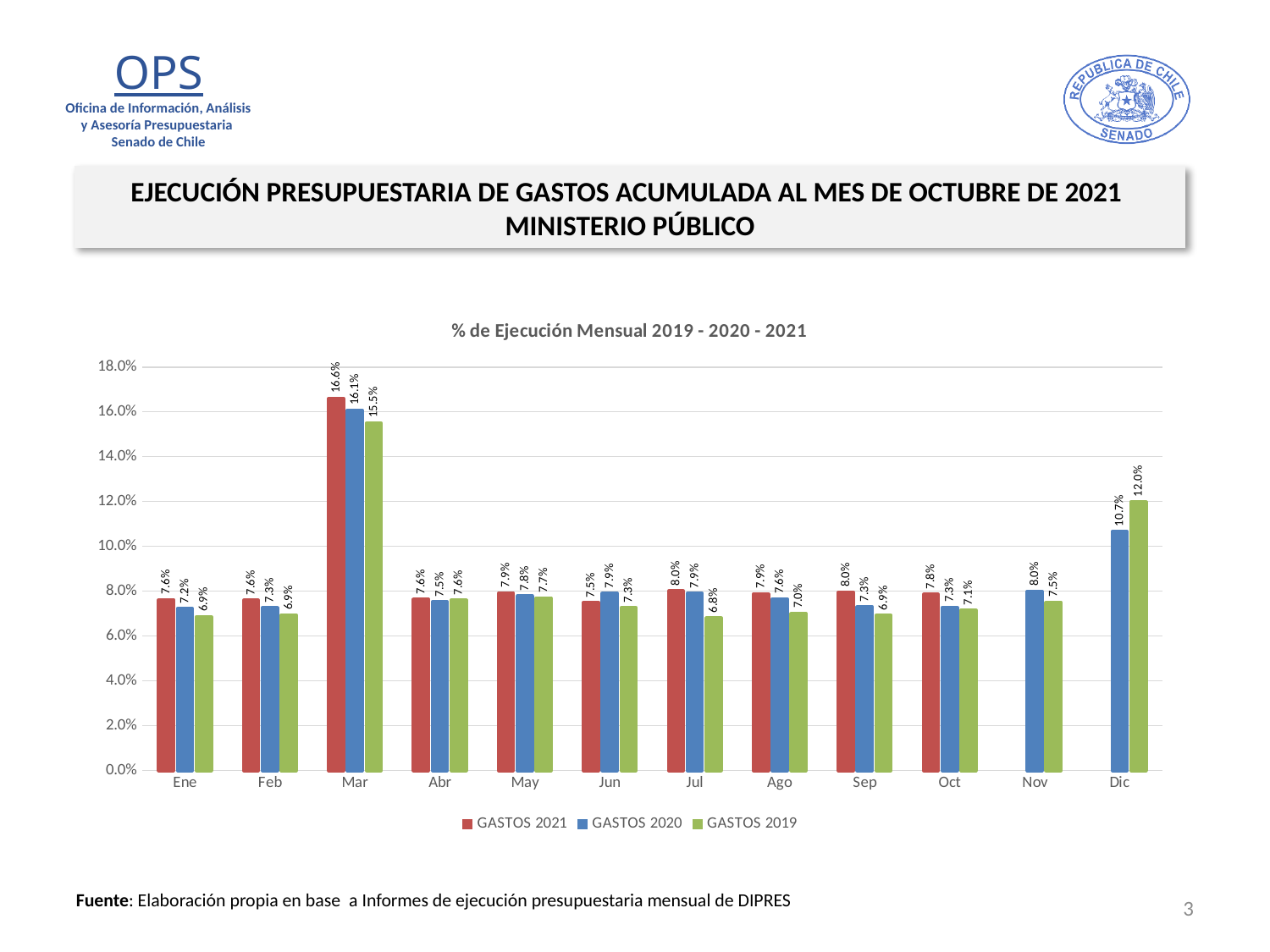
What is the difference between GASTOS 2021 and GASTOS 2019 in Mar? 1.1% How many series does the legend list? 3 What is the value for GASTOS 2019 in Dic? 12.0% In Dic, which is larger: GASTOS 2020 or GASTOS 2019? GASTOS 2019 Which month has the lowest value for GASTOS 2019? Jul What kind of chart is shown on the slide? bar chart What is the value for GASTOS 2020 in Nov? 8.0% How many months are shown on the x axis? 12 What is the title of the chart? % de Ejecución Mensual 2019 - 2020 - 2021 What is the value for GASTOS 2021 in Mar? 16.6% Which month has the highest value for GASTOS 2020? Mar Is the value for GASTOS 2020 in Dic greater or less than 10.0%? greater